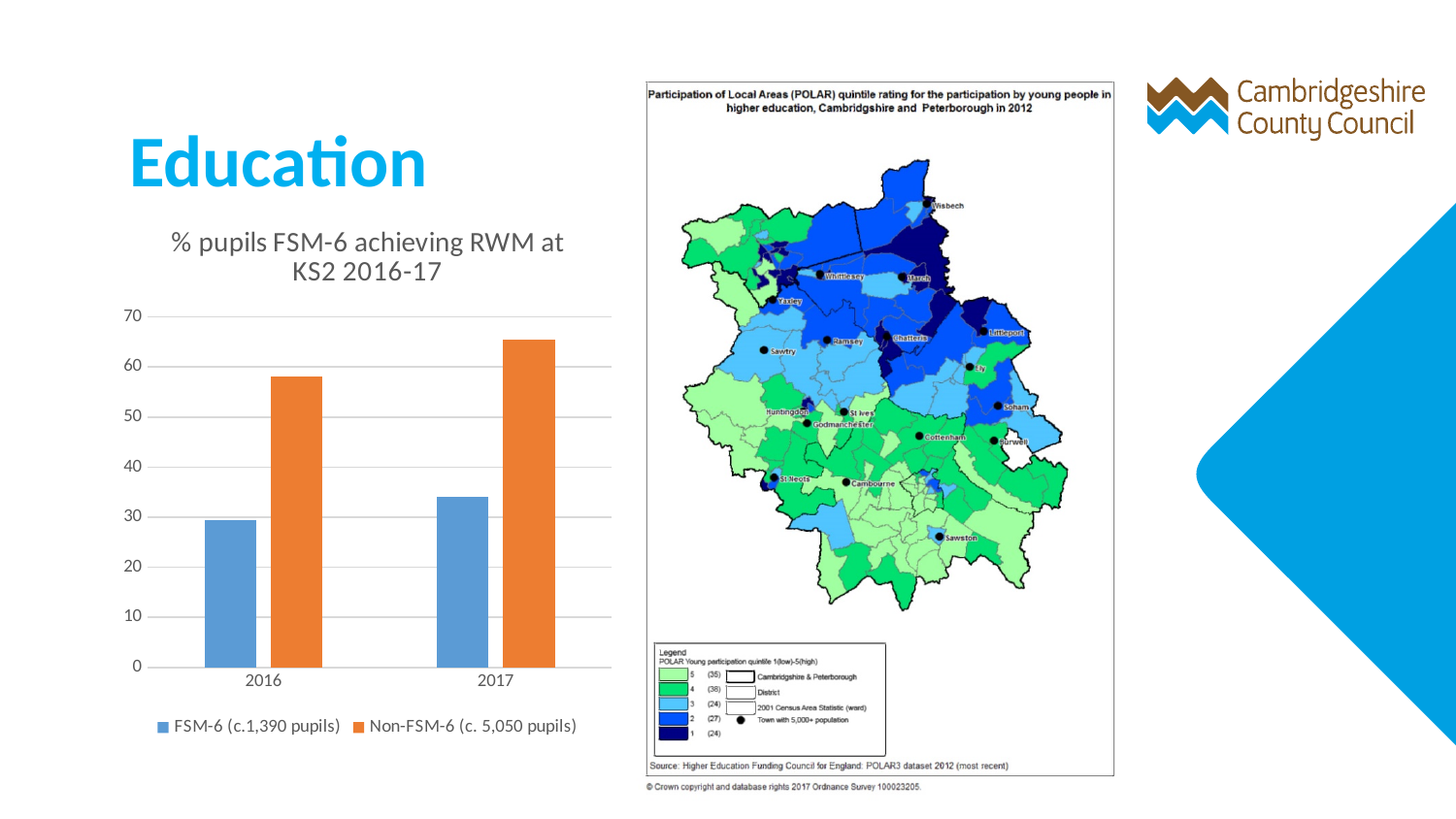
How many categories are shown on the x axis of the bar chart? 2 What is the title of the bar chart on the slide? % pupils FSM-6 achieving RWM at KS2 2016-17 In the bar chart, is the value for Non-FSM-6 in 2016 greater or less than 50? greater In the bar chart, do the values for Non-FSM-6 rise or fall from 2016 to 2017? rise What kind of chart is shown under the title '% pupils FSM-6 achieving RWM at KS2 2016-17'? bar chart In the bar chart, what colour are the Non-FSM-6 bars? orange In the bar chart, which year has the higher value for FSM-6 pupils? 2017 In the bar chart, which series has the larger value in 2017, FSM-6 or Non-FSM-6? Non-FSM-6 In the bar chart, is the value for FSM-6 in 2017 greater or less than 40? less In the bar chart, is the value for Non-FSM-6 in 2017 greater or less than 60? greater How many series does the legend of the bar chart list? 2